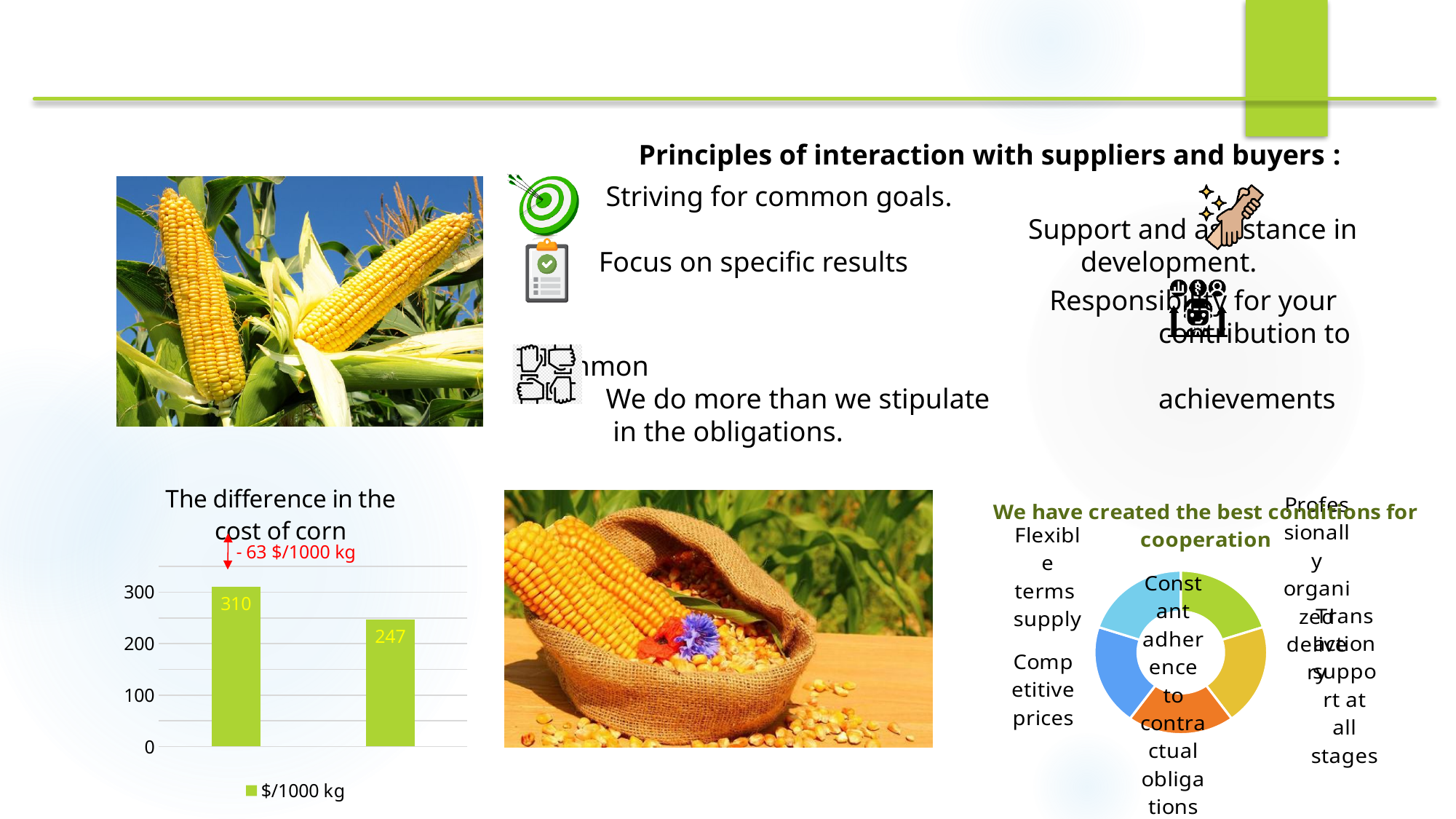
What kind of chart is the one titled 'We have created the best conditions for cooperation'? doughnut chart In the bar chart titled 'The difference in the cost of corn', is the value of the right bar greater or less than 300? less In the bar chart titled 'The difference in the cost of corn', what is the difference between the two bars? 63 In the bar chart titled 'The difference in the cost of corn', what series name does the legend show? $/1000 kg In the bar chart titled 'The difference in the cost of corn', what is the value of the left bar? 310 In the bar chart titled 'The difference in the cost of corn', what is the value of the right bar? 247 In the bar chart titled 'The difference in the cost of corn', what difference is annotated in red above the bars? - 63 $/1000 kg In the bar chart titled 'The difference in the cost of corn', do the values rise or fall from left to right? fall In the chart titled 'We have created the best conditions for cooperation', how many segments are there? 5 What kind of chart is the one titled 'The difference in the cost of corn'? bar chart In the bar chart titled 'The difference in the cost of corn', which bar is taller, the left or the right? left In the bar chart titled 'The difference in the cost of corn', how many bars are plotted? 2